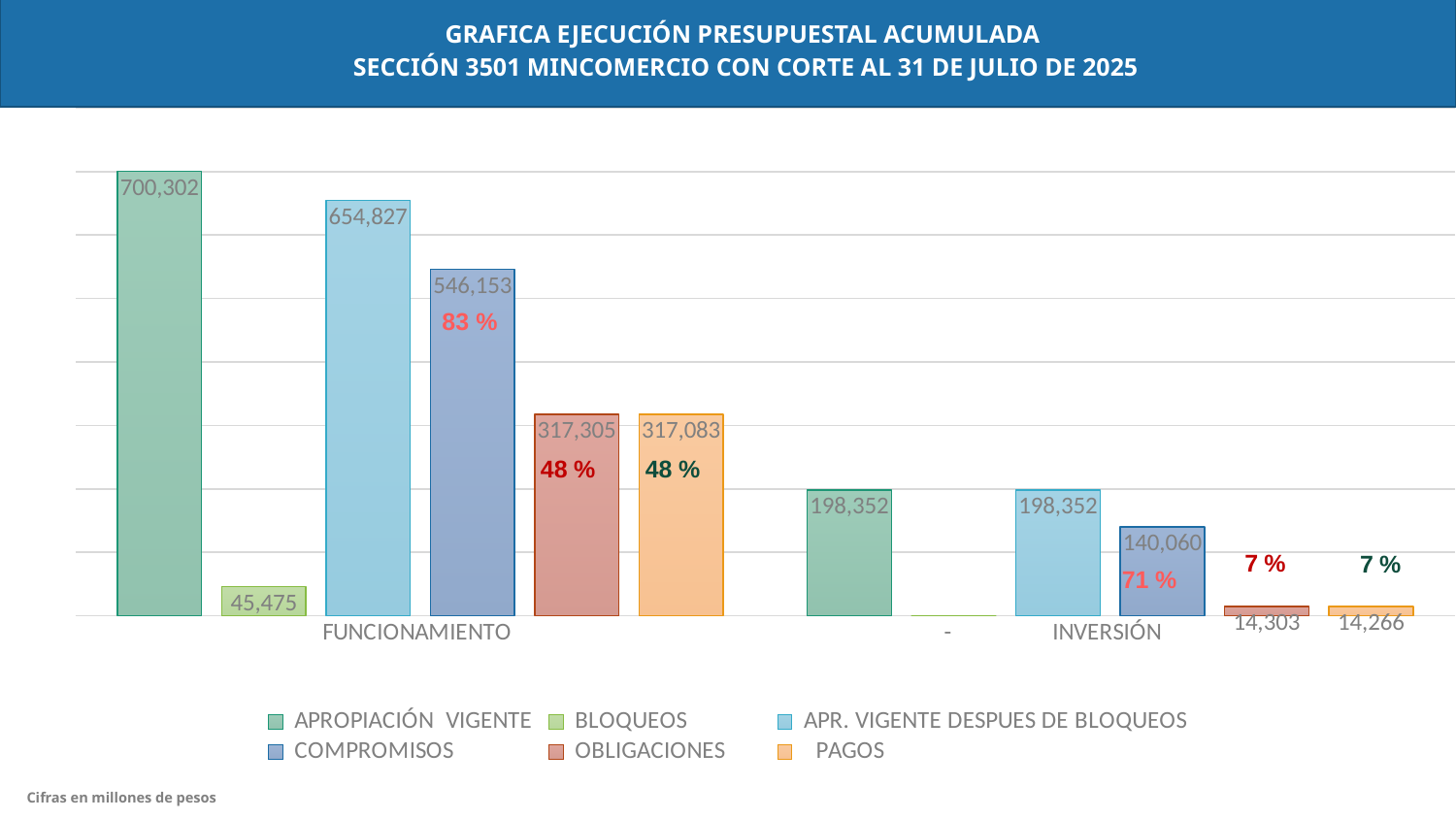
How many series does the legend list? 6 What is the difference between APR. VIGENTE DESPUES DE BLOQUEOS and COMPROMISOS for INVERSIÓN? 58,292 Which series has the highest value for FUNCIONAMIENTO? APROPIACIÓN VIGENTE What is the difference between APROPIACIÓN VIGENTE and APR. VIGENTE DESPUES DE BLOQUEOS for FUNCIONAMIENTO? 45,475 What is the value of PAGOS for INVERSIÓN? 14,266 Which series has the lowest value for INVERSIÓN? BLOQUEOS What is the value of BLOQUEOS for FUNCIONAMIENTO? 45,475 What is the value of APROPIACIÓN VIGENTE for FUNCIONAMIENTO? 700,302 What is the value of COMPROMISOS for INVERSIÓN? 140,060 What kind of chart is shown on the slide? Bar chart Which is larger, COMPROMISOS for FUNCIONAMIENTO or COMPROMISOS for INVERSIÓN? COMPROMISOS for FUNCIONAMIENTO What percentage is shown above the OBLIGACIONES bar for FUNCIONAMIENTO? 48 %